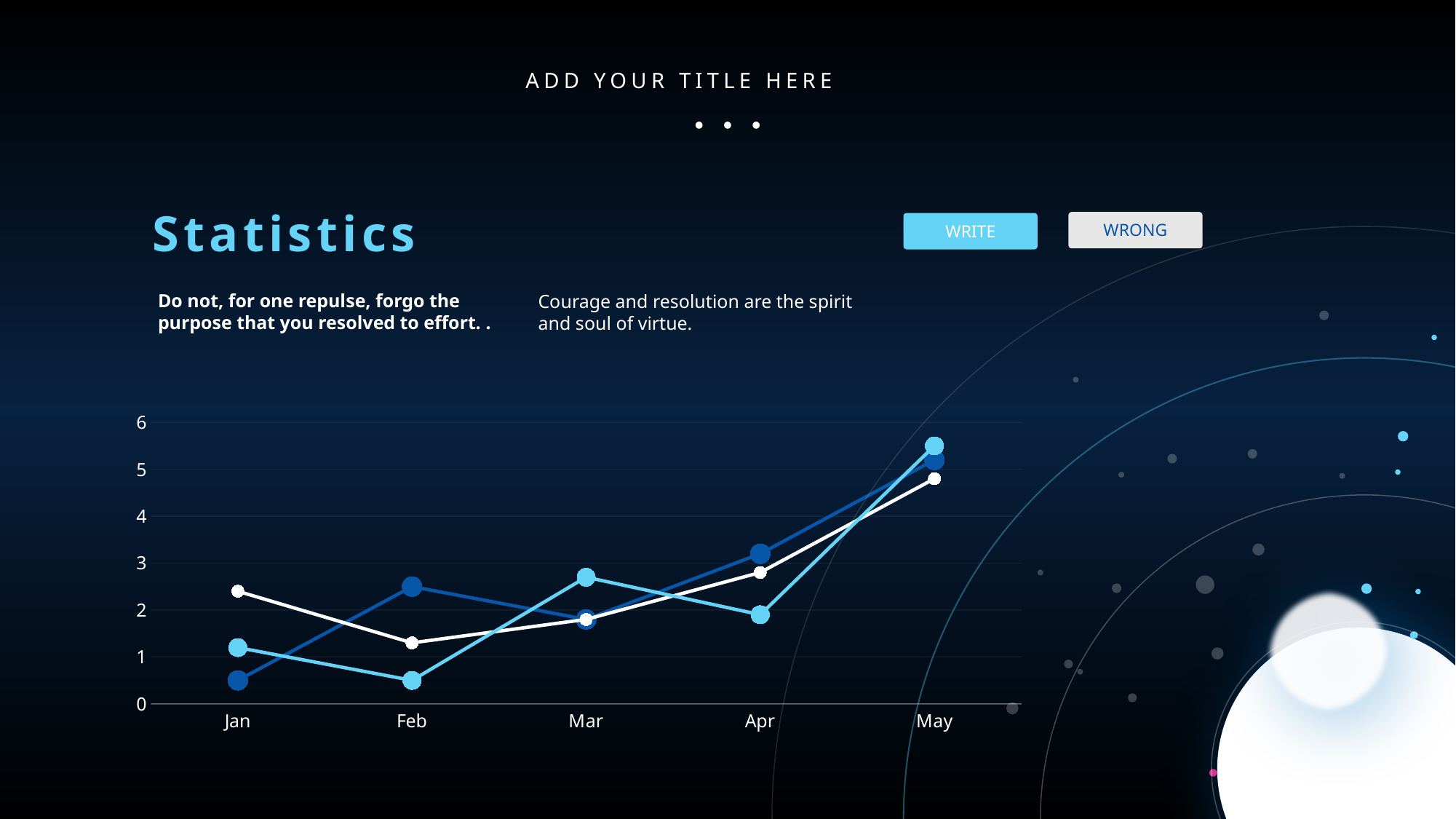
In Jan, which line has the larger value, the white line or the dark blue line? white line Is the value of the dark blue line in Jan greater or less than 1? less What kind of chart is shown on the slide? line chart Is the value of the white line in Jan greater or less than 2? greater In which month does the light blue line reach its highest value? May In which month does the light blue line have its lowest value? Feb Is the value of the light blue line in May greater or less than 5? greater In Feb, which line has the larger value, the dark blue line or the light blue line? dark blue line In which month does the dark blue line have its lowest value? Jan Does the white line rise or fall from Apr to May? rise How many lines are plotted on the chart? 3 How many months are shown on the x axis of the chart? 5